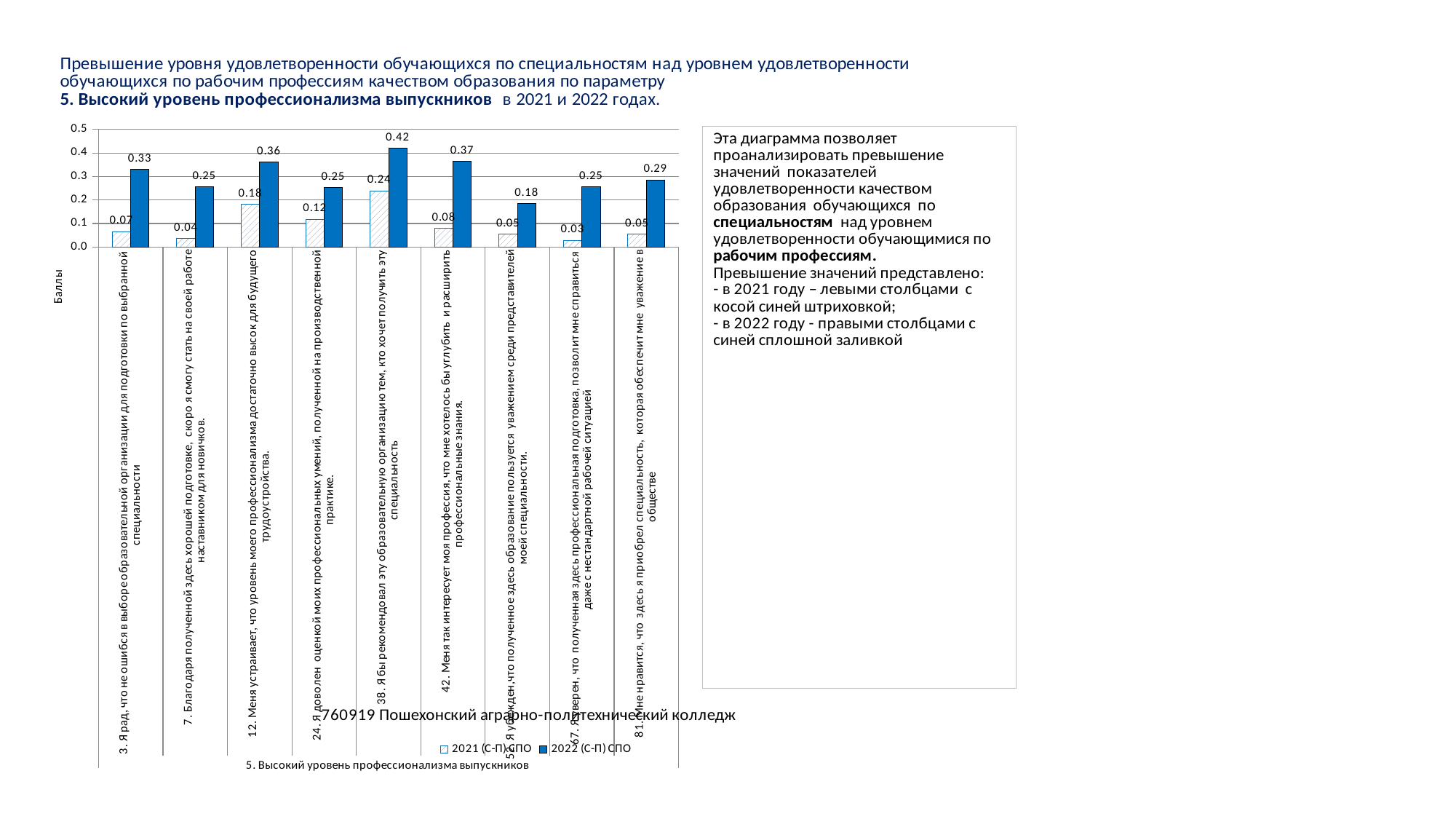
Which statement has the highest 2022 (С-П) СПО value? 38. Я бы рекомендовал эту образовательную организацию тем, кто хочет получить эту специальность What is the label of the vertical axis? Баллы Which is larger for statement 24 ("Я доволен оценкой моих профессиональных умений..."): the 2021 value or the 2022 value? 2022 value How many categories (statements) are plotted on the chart? 9 What is the 2021 (С-П) СПО value for statement 12 ("Меня устраивает, что уровень моего профессионализма...")? 0.18 Which statement has the lowest 2021 (С-П) СПО value? 67. Я уверен, что полученная здесь профессиональная подготовка, позволит мне справиться даже с нестандартной рабочей ситуацией What is the 2022 (С-П) СПО value for statement 3 ("Я рад, что не ошибся в выборе образовательной организации...")? 0.33 What type of chart is shown on the slide? bar chart How many series does the legend list? 2 What is the difference between the 2022 and 2021 values for statement 42 ("Меня так интересует моя профессия...")? 0.29 Is the 2022 (С-П) СПО value for statement 7 ("Благодаря полученной здесь хорошей подготовке...") greater or less than 0.2? greater What is the 2022 (С-П) СПО value for statement 38 ("Я бы рекомендовал эту образовательную организацию...")? 0.42